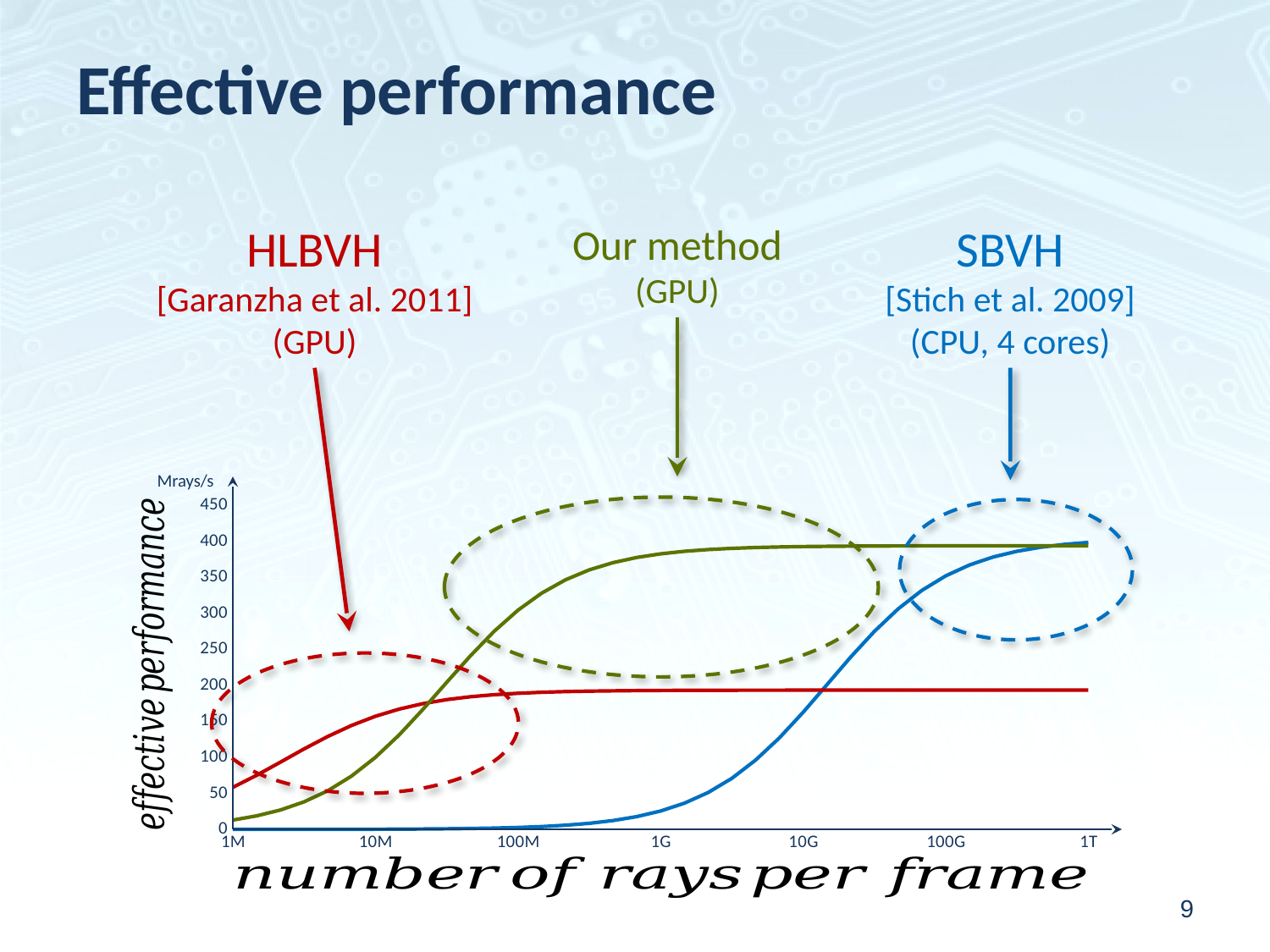
Does the SBVH curve rise or fall as the number of rays per frame increases? rise How many tick labels are shown on the x axis? 7 How many methods (curves) are plotted on the chart? 3 What unit is shown at the top of the y axis? Mrays/s Is the value for Our method at 1T rays per frame greater or less than 350 Mrays/s? greater Is the value for SBVH at 1M rays per frame greater or less than 50 Mrays/s? less Is the value for HLBVH at 1M rays per frame greater or less than 100 Mrays/s? less At 1G rays per frame, which has the higher effective performance, Our method or SBVH? Our method At 10M rays per frame, which has the higher effective performance, HLBVH or Our method? HLBVH What kind of chart is shown on the slide? line chart What is the label of the x axis? number of rays per frame